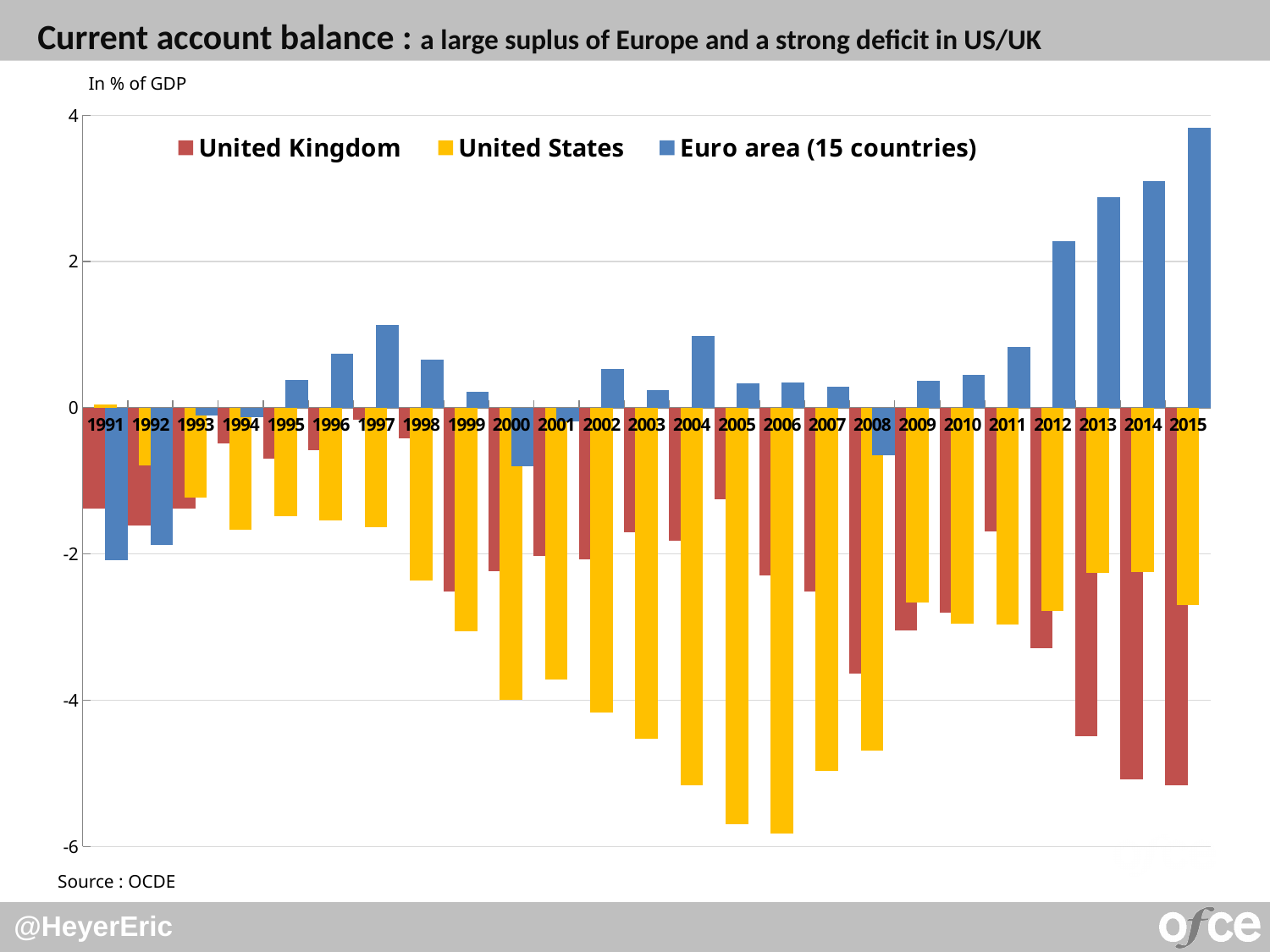
Is the Euro area (15 countries) value for 2015 greater or less than 2? greater In 2015, which is larger: the United Kingdom value or the United States value? United States Do the Euro area (15 countries) values rise or fall from 2011 to 2015? rise How many years are shown on the x axis? 25 In which year is the Euro area (15 countries) value highest? 2015 How many series does the legend list? 3 What unit is stated above the chart for the values? In % of GDP In which year is the Euro area (15 countries) value lowest? 1991 Is the United States value for 2006 greater or less than -4? less What kind of chart is shown on the slide? bar chart Is the United Kingdom value for 2014 greater or less than -4? less